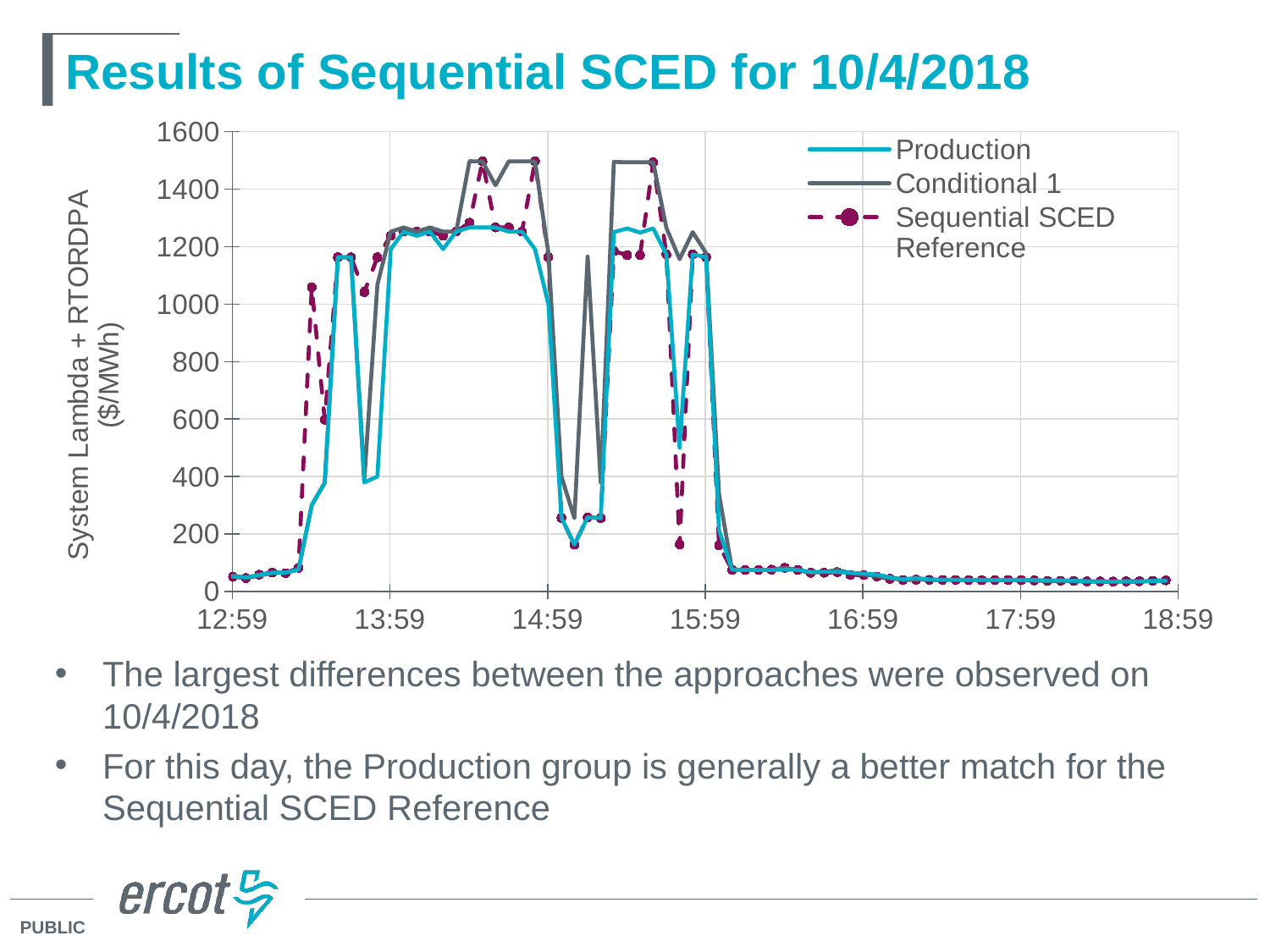
What is the title of the chart? Results of Sequential SCED for 10/4/2018 Do the values for Production rise or fall between 15:59 and 16:59? fall What is the label on the vertical axis of the chart? System Lambda + RTORDPA ($/MWh) What kind of chart is shown on the slide? Line chart How many time labels are shown on the x axis? 7 Is the value for Conditional 1 at 18:59 greater or less than 200? less Which series has the lowest peak value over the day? Production Is the value for Production at 12:59 greater or less than 200? less Is the value for Sequential SCED Reference at 16:59 greater or less than 200? less How many series does the legend list? 3